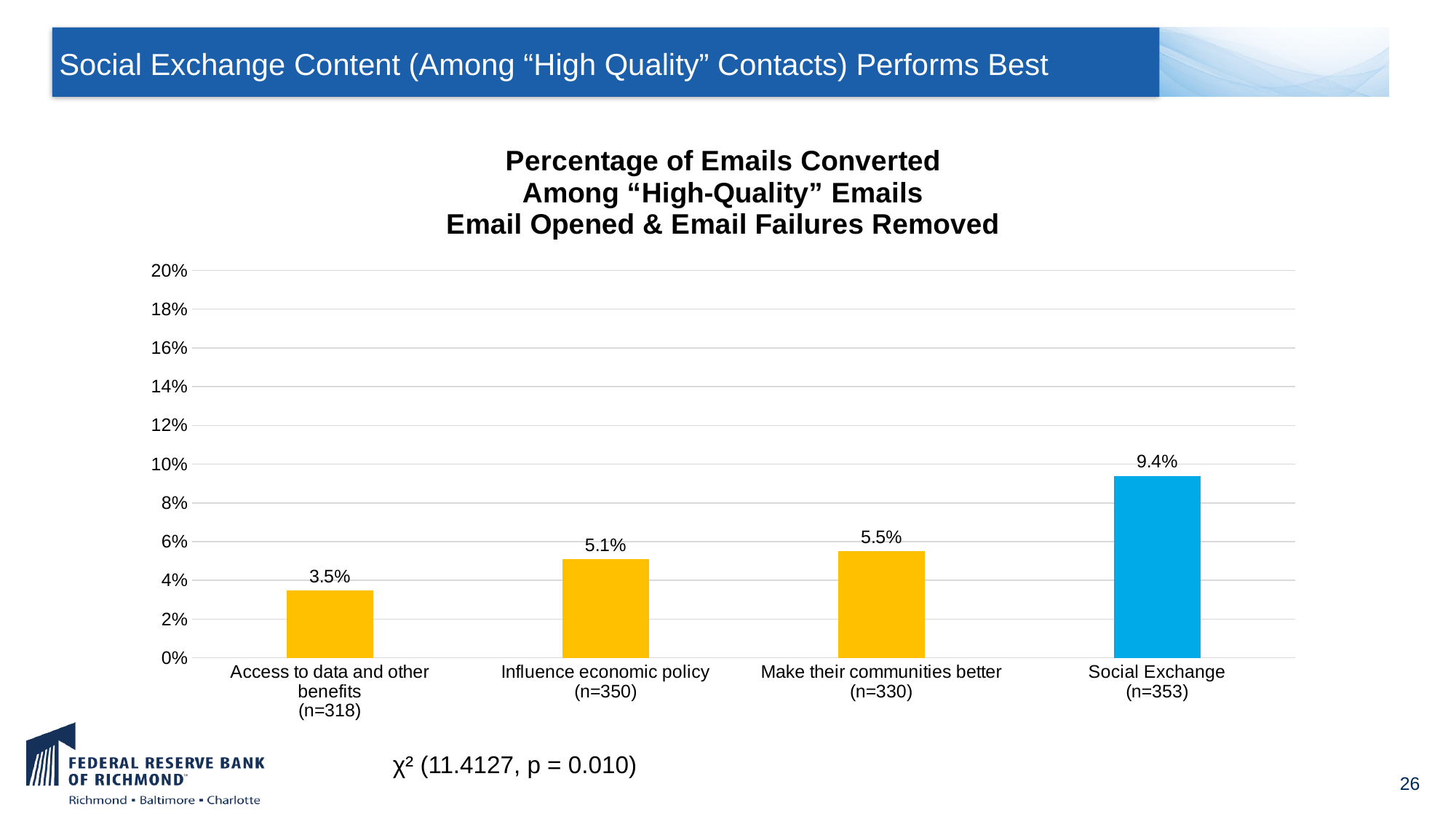
Which category has the highest percentage of emails converted? Social Exchange What is the percentage of emails converted for Social Exchange? 9.4% What is the sample size (n) shown for the Social Exchange category? n=353 How many categories are shown on the chart? 4 What is the difference in percentage points between Social Exchange and Access to data and other benefits? 5.9 What is the percentage of emails converted for Make their communities better? 5.5% Is the value for Social Exchange greater or less than 8%? greater What is the percentage of emails converted for Influence economic policy? 5.1% What is the percentage of emails converted for Access to data and other benefits? 3.5% Which is larger: the value for Influence economic policy or Make their communities better? Make their communities better What kind of chart is shown on the slide? Bar chart Which category has the lowest percentage of emails converted? Access to data and other benefits